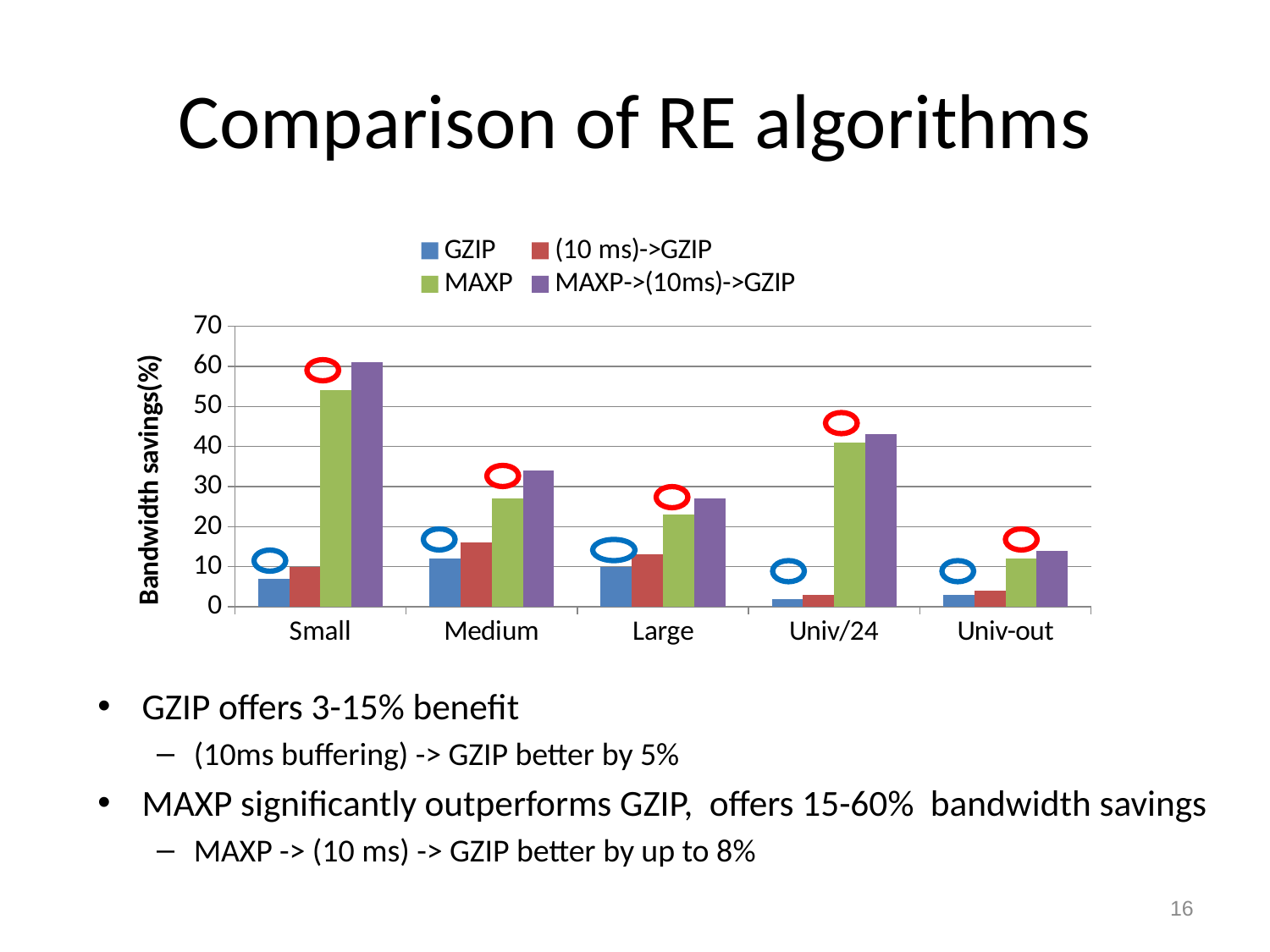
Which category has the lowest GZIP bandwidth savings? Univ/24 Is the GZIP value for Medium greater or less than 10? greater What is the label of the y axis? Bandwidth savings(%) How many categories are shown on the x axis? 5 What kind of chart is shown on the slide? bar chart Which is larger: the MAXP value for Medium or the MAXP value for Univ/24? Univ/24 Which category has the highest MAXP bandwidth savings? Small Which is larger for Large: the MAXP value or the GZIP value? MAXP Is the MAXP value for Univ-out greater or less than 20? less How many series does the legend list? 4